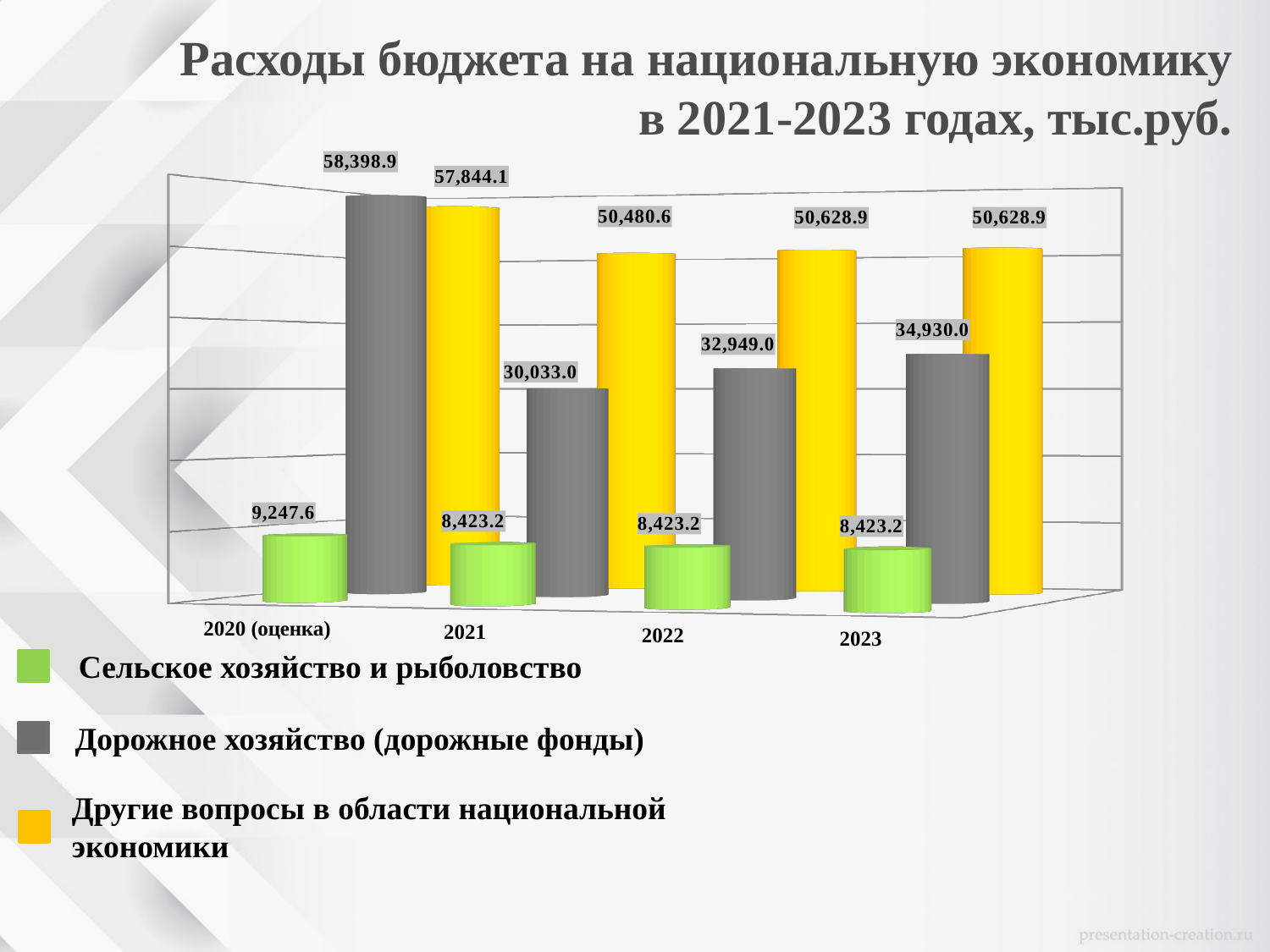
How many years are shown on the x axis of the chart? 4 Which is larger in 2020 (оценка): Дорожное хозяйство (дорожные фонды) or Другие вопросы в области национальной экономики? Дорожное хозяйство (дорожные фонды) In which year is the value for Дорожное хозяйство (дорожные фонды) highest? 2020 (оценка) What is the difference between the Другие вопросы в области национальной экономики value and the Сельское хозяйство и рыболовство value in 2021? 42,057.4 What is the value for Дорожное хозяйство (дорожные фонды) in 2020 (оценка)? 58,398.9 What is the value for Другие вопросы в области национальной экономики in 2021? 50,480.6 Does the value for Дорожное хозяйство (дорожные фонды) rise or fall from 2021 to 2023? rise What is the difference between the Дорожное хозяйство (дорожные фонды) values in 2023 and 2022? 1,981.0 What is the value for Сельское хозяйство и рыболовство in 2020 (оценка)? 9,247.6 In which year is the value for Дорожное хозяйство (дорожные фонды) lowest? 2021 What is the value for Дорожное хозяйство (дорожные фонды) in 2023? 34,930.0 How many series does the legend list? 3